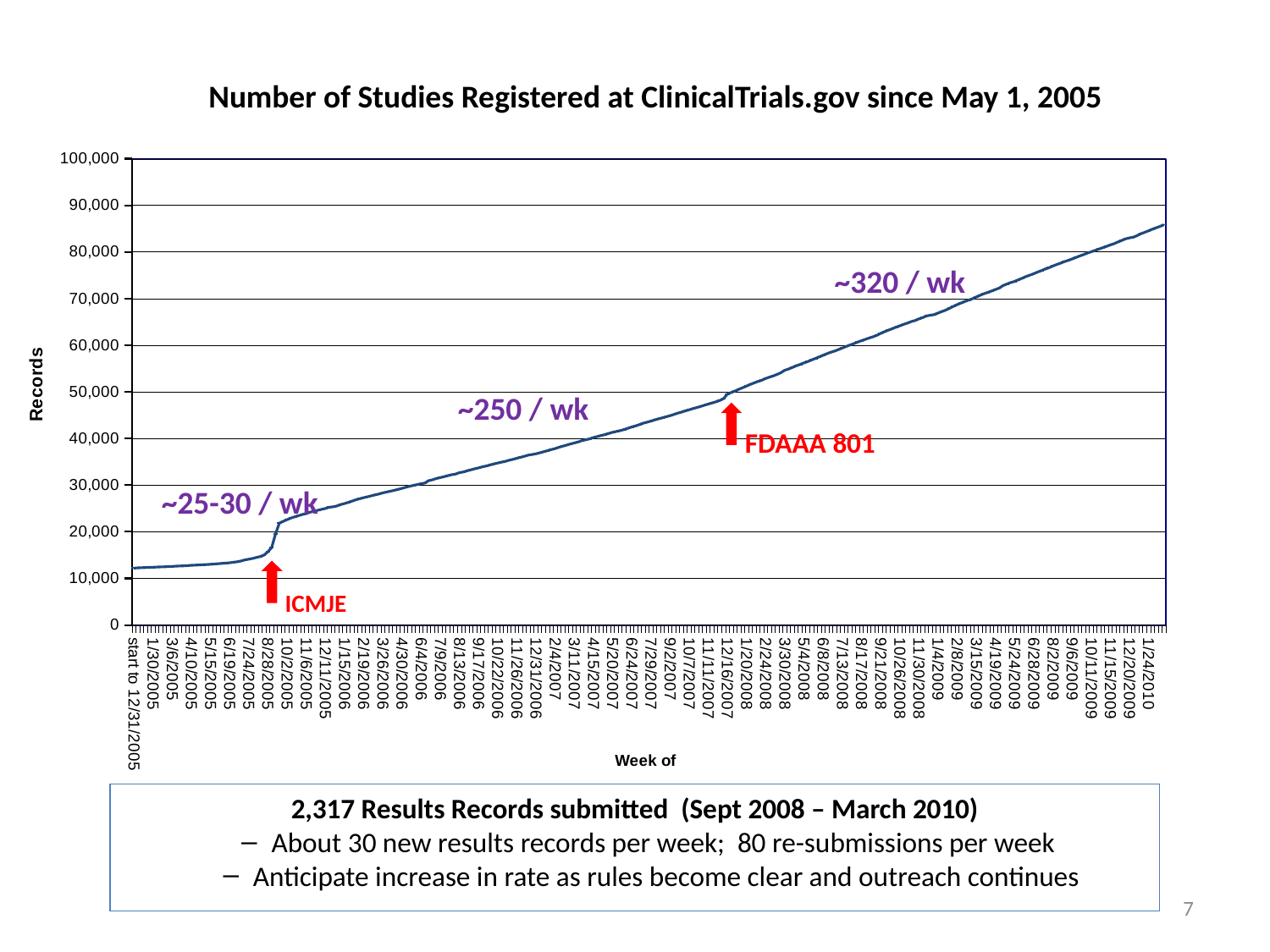
Is the value for the week of 1/24/2010 greater or less than 80,000? greater Is the value for the week of 1/30/2005 greater or less than 20,000? less What kind of chart is shown on the slide? line chart Is the value for the week of 8/17/2008 greater or less than 50,000? greater What is the title of the chart? Number of Studies Registered at ClinicalTrials.gov since May 1, 2005 Do the values rise or fall along the x axis from 2005 to 2010? rise What weekly rate is annotated on the chart for the period after FDAAA 801? ~320 / wk Which is larger, the value for the week of 1/24/2010 or the value for the week of 1/30/2005? 1/24/2010